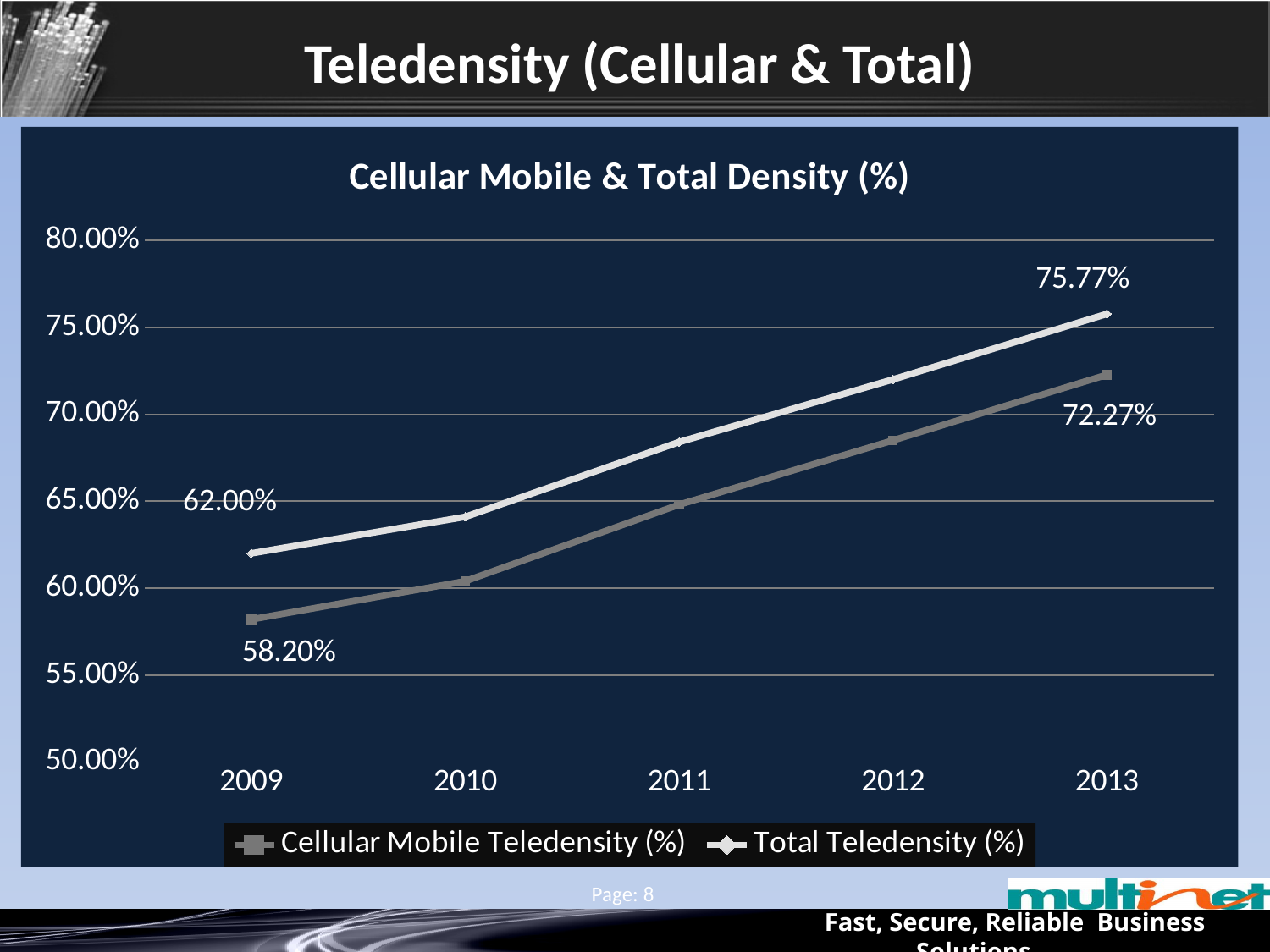
Is the Total Teledensity value for 2011 greater or less than 65.00%? greater What type of chart is shown on the slide? Line chart What is the Cellular Mobile Teledensity (%) value for 2009? 58.20% How many series does the legend list? 2 What is the difference between Total Teledensity and Cellular Mobile Teledensity in 2013? 3.50% What is the Total Teledensity (%) value for 2009? 62.00% What is the Cellular Mobile Teledensity (%) value for 2013? 72.27% How many years are shown on the x axis? 5 Is the Total Teledensity value for 2010 greater or less than 65.00%? less By how much did Cellular Mobile Teledensity increase from 2009 to 2013? 14.07% What is the Total Teledensity (%) value for 2013? 75.77% Which series has the higher value in 2011, Cellular Mobile Teledensity or Total Teledensity? Total Teledensity (%)